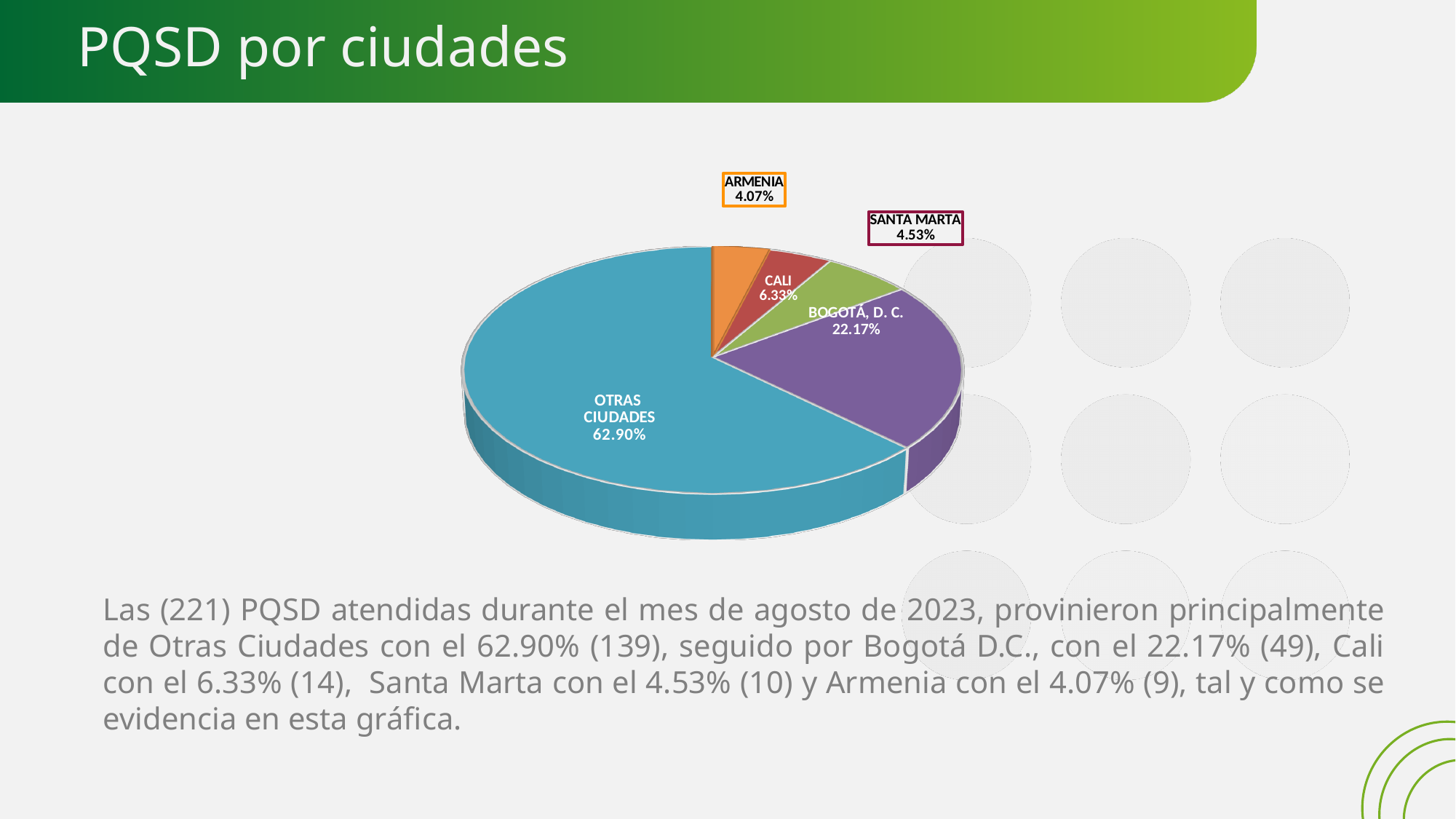
What is the value shown for CALI? 6.33% What type of chart is shown on the slide? pie chart Which city has the smallest slice of the pie? ARMENIA What is the title of the slide containing the chart? PQSD por ciudades How many slices does the pie chart have? 5 What share of the pie does OTRAS CIUDADES represent? 62.90% What is the value shown for ARMENIA? 4.07% What is the difference between the shares of BOGOTÁ, D. C. and CALI? 15.84% What is the value shown for SANTA MARTA? 4.53% Which city has the largest slice of the pie? OTRAS CIUDADES Which has a larger share, SANTA MARTA or ARMENIA? SANTA MARTA What is the value shown for BOGOTÁ, D. C.? 22.17%